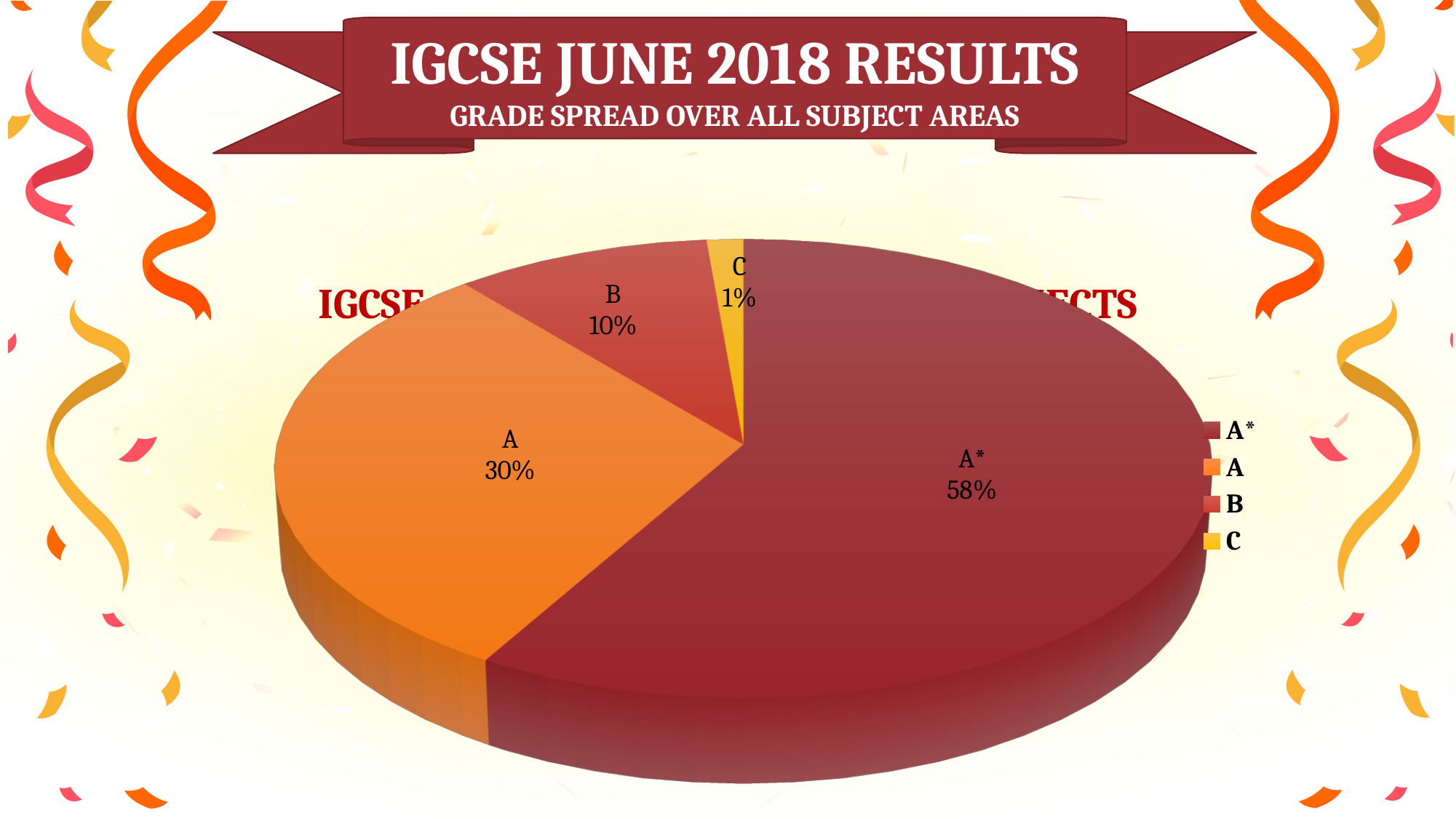
What percentage of grades were A*? 58% Which slice is larger, B or C? B What percentage of grades were B? 10% Which grade has the largest share of the pie? A* What percentage of grades were C? 1% What colour is the A slice in the pie chart? Orange What kind of chart is shown on the slide? Pie chart Which grade has the smallest share of the pie? C What is the difference in percentage points between the A* and A slices? 28 What percentage of grades were A? 30% How many grade categories are shown in the pie chart? 4 What is the subtitle of the slide below 'IGCSE JUNE 2018 RESULTS'? GRADE SPREAD OVER ALL SUBJECT AREAS